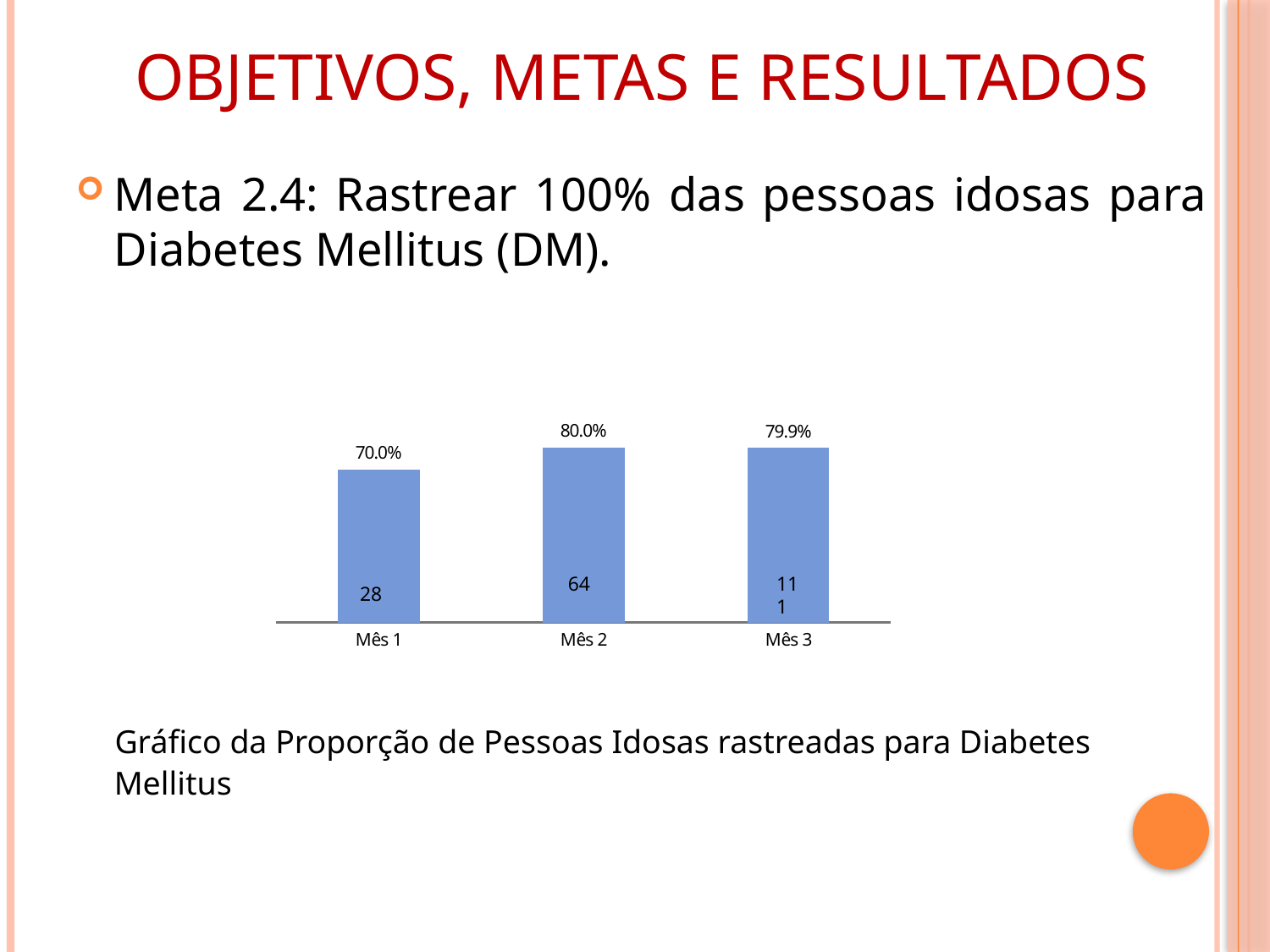
What percentage is shown above the bar for Mês 1? 70.0% Which month has the lowest percentage? Mês 1 Does the percentage rise or fall from Mês 1 to Mês 2? Rise What percentage is shown above the bar for Mês 3? 79.9% What kind of chart is shown on the slide? Bar chart What number is printed inside the bar for Mês 2? 64 What number is printed inside the bar for Mês 1? 28 Which month has the highest percentage? Mês 2 Which has a higher percentage, Mês 1 or Mês 3? Mês 3 What is the difference in percentage between Mês 2 and Mês 1? 10.0 percentage points How many months (bars) are shown in the chart? 3 What percentage is shown above the bar for Mês 2? 80.0%